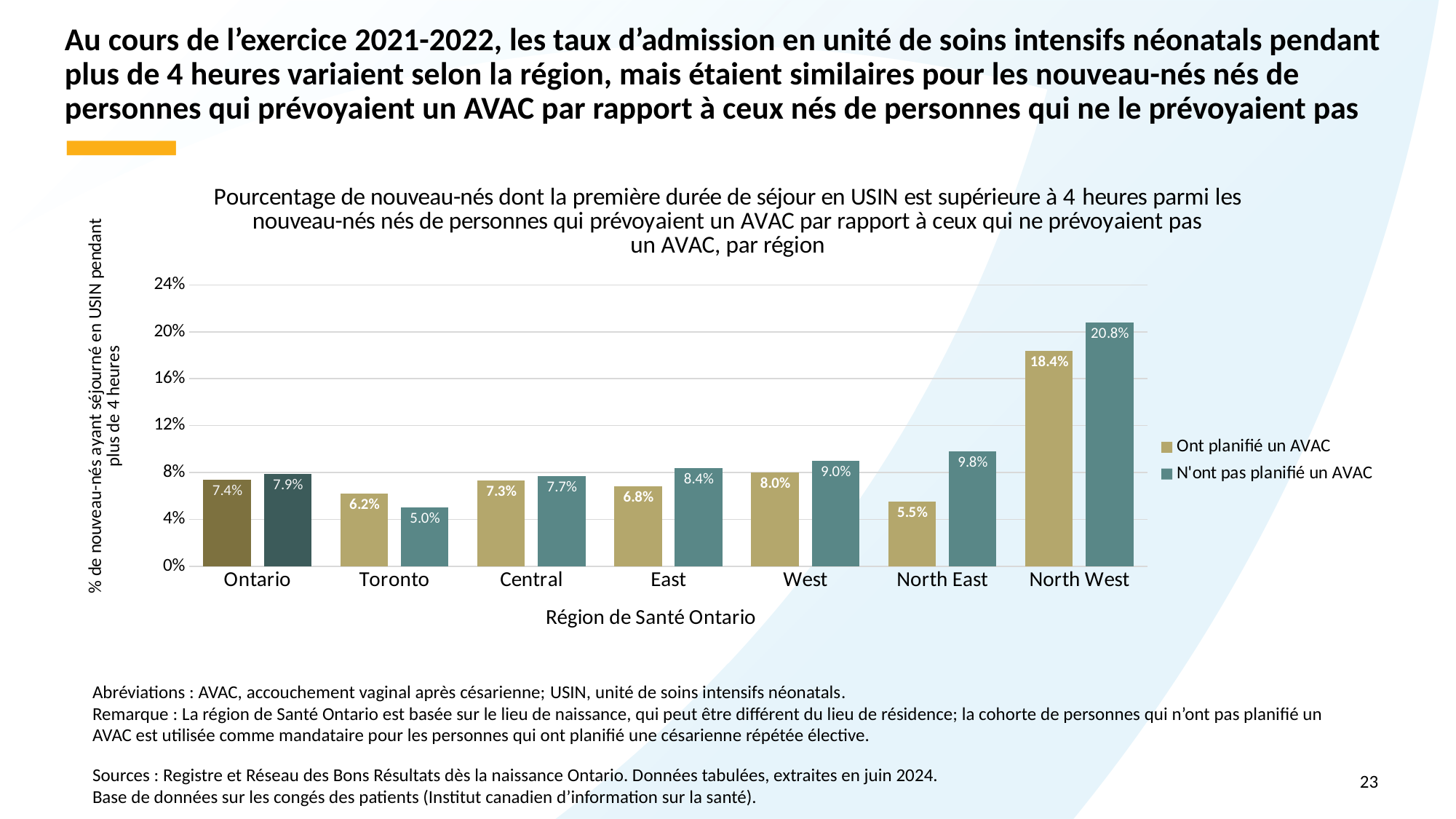
What is the value for Ontario in the 'Ont planifié un AVAC' series? 7.4% Which region has the lowest value in the 'Ont planifié un AVAC' series? North East What kind of chart is shown on the slide? Bar chart What is the value for North West in the 'N'ont pas planifié un AVAC' series? 20.8% What is the value for Toronto in the 'Ont planifié un AVAC' series? 6.2% How many regions are shown on the x axis? 7 What is the difference between the 'N'ont pas planifié un AVAC' and 'Ont planifié un AVAC' values for North West? 2.4% What is the x-axis title of the chart? Région de Santé Ontario Which region has the highest value in the 'N'ont pas planifié un AVAC' series? North West For Toronto, which series has the larger value: 'Ont planifié un AVAC' or 'N'ont pas planifié un AVAC'? Ont planifié un AVAC How many series does the legend list? 2 Is the value for North West in the 'Ont planifié un AVAC' series greater or less than 16%? greater